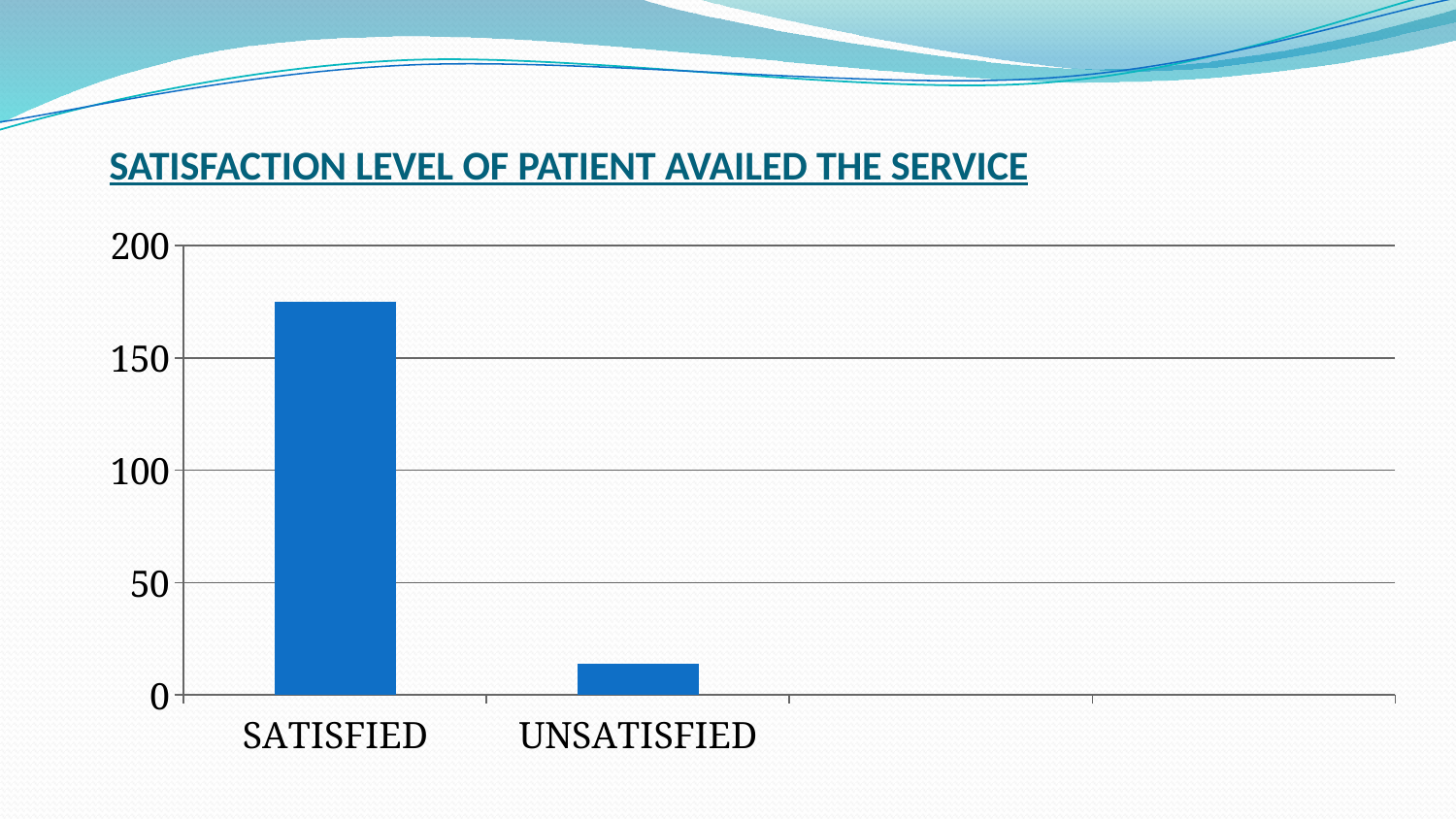
Is the value for SATISFIED greater or less than 150? greater Which is larger, the value for SATISFIED or the value for UNSATISFIED? SATISFIED What is the highest value shown on the vertical axis? 200 What kind of chart is shown on the slide? bar chart Which category has the lowest value? UNSATISFIED What is the title of the chart? SATISFACTION LEVEL OF PATIENT AVAILED THE SERVICE Is the value for SATISFIED greater or less than 200? less Which category has the highest value? SATISFIED Is the value for UNSATISFIED greater or less than 50? less How many categories are plotted on the chart? 2